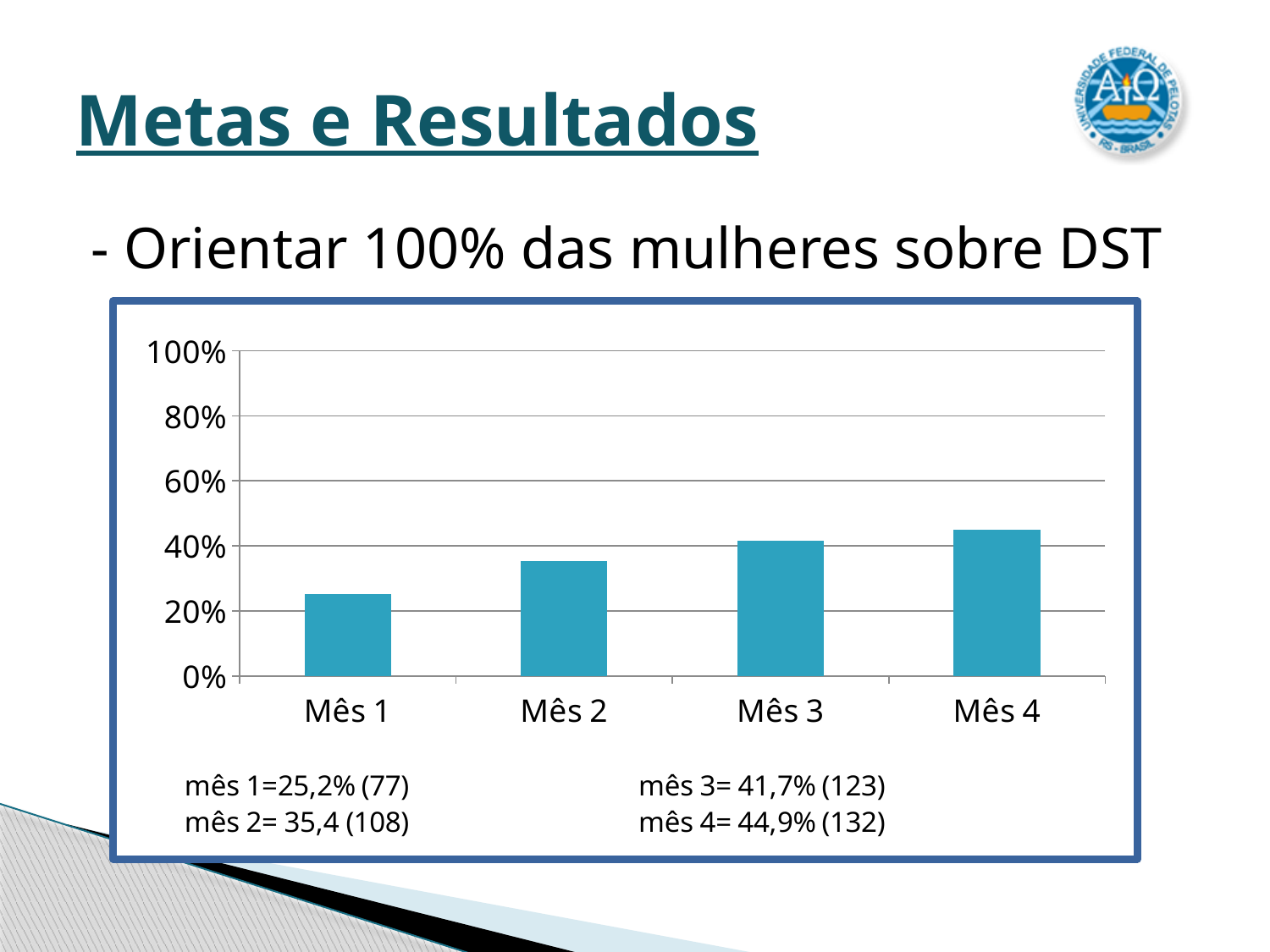
Which month has the lowest value on the chart? Mês 1 Which is larger, the value for Mês 1 or the value for Mês 3? Mês 3 Do the values rise or fall from Mês 1 to Mês 4? rise According to the text below the chart, what is the value for mês 4? 44,9% (132) What kind of chart is shown on the slide? bar chart What is the difference in percentage points between mês 4 (44,9%) and mês 1 (25,2%)? 19,7 Is the value for Mês 2 greater or less than 40%? less Is the value for Mês 4 greater or less than 40%? greater Which month has the highest value on the chart? Mês 4 How many categories (months) are plotted on the chart? 4 According to the text below the chart, what is the value for mês 1? 25,2% (77) According to the text below the chart, what is the value for mês 3? 41,7% (123)